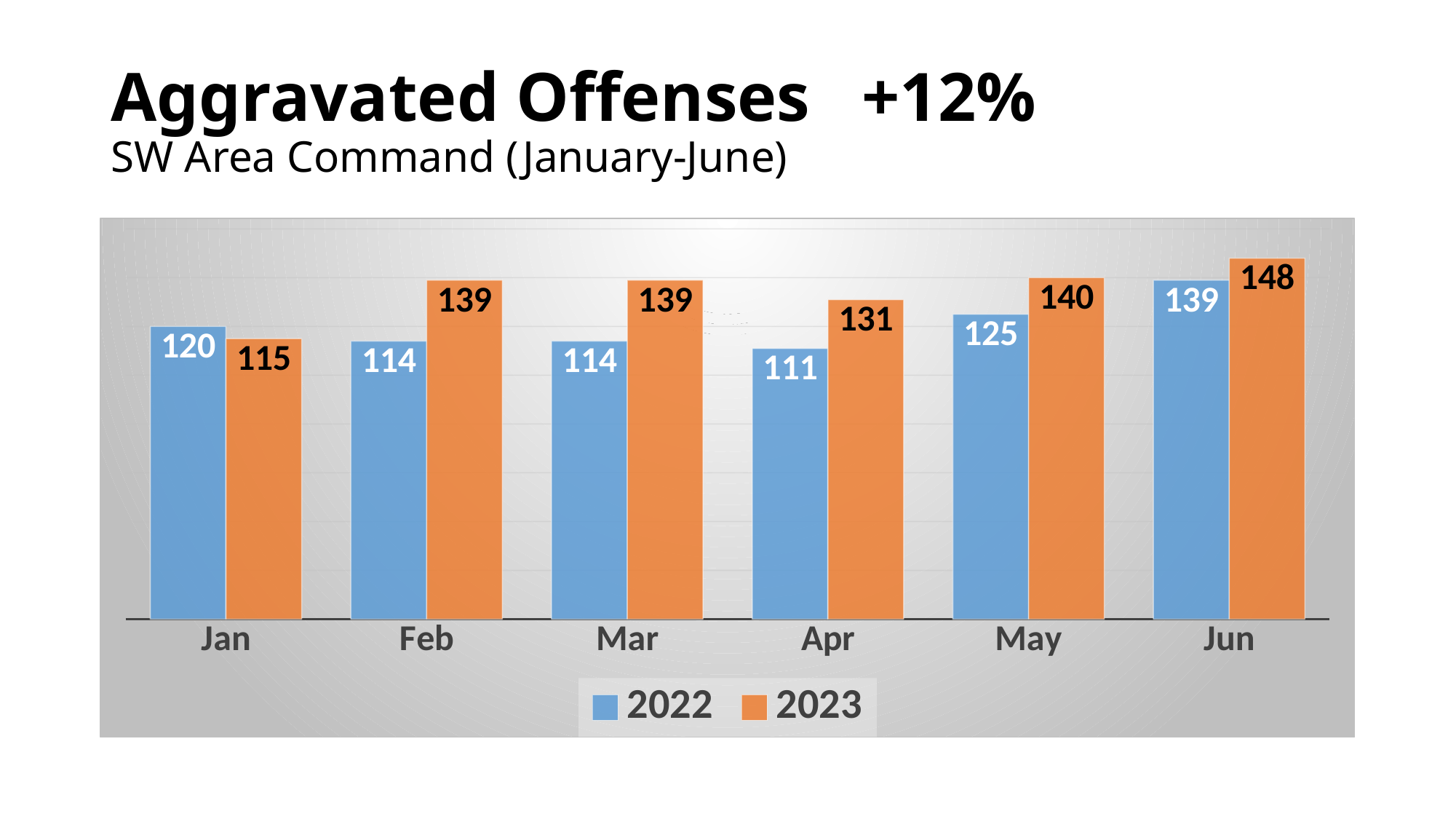
How many series does the legend list? 2 What is the value for 2022 in Jan? 120 Which month has the lowest value for 2022? Apr Which month has the highest value for 2023? Jun What kind of chart is shown on the slide? bar chart What is the value for 2023 in Jun? 148 What percentage change is shown next to the chart title? +12% What is the difference between the 2023 and 2022 values in Feb? 25 What is the value for 2023 in Apr? 131 How many months are shown on the x axis? 6 Do the 2023 values rise or fall from Apr to Jun? rise Which is larger in Jan, the 2022 value or the 2023 value? 2022